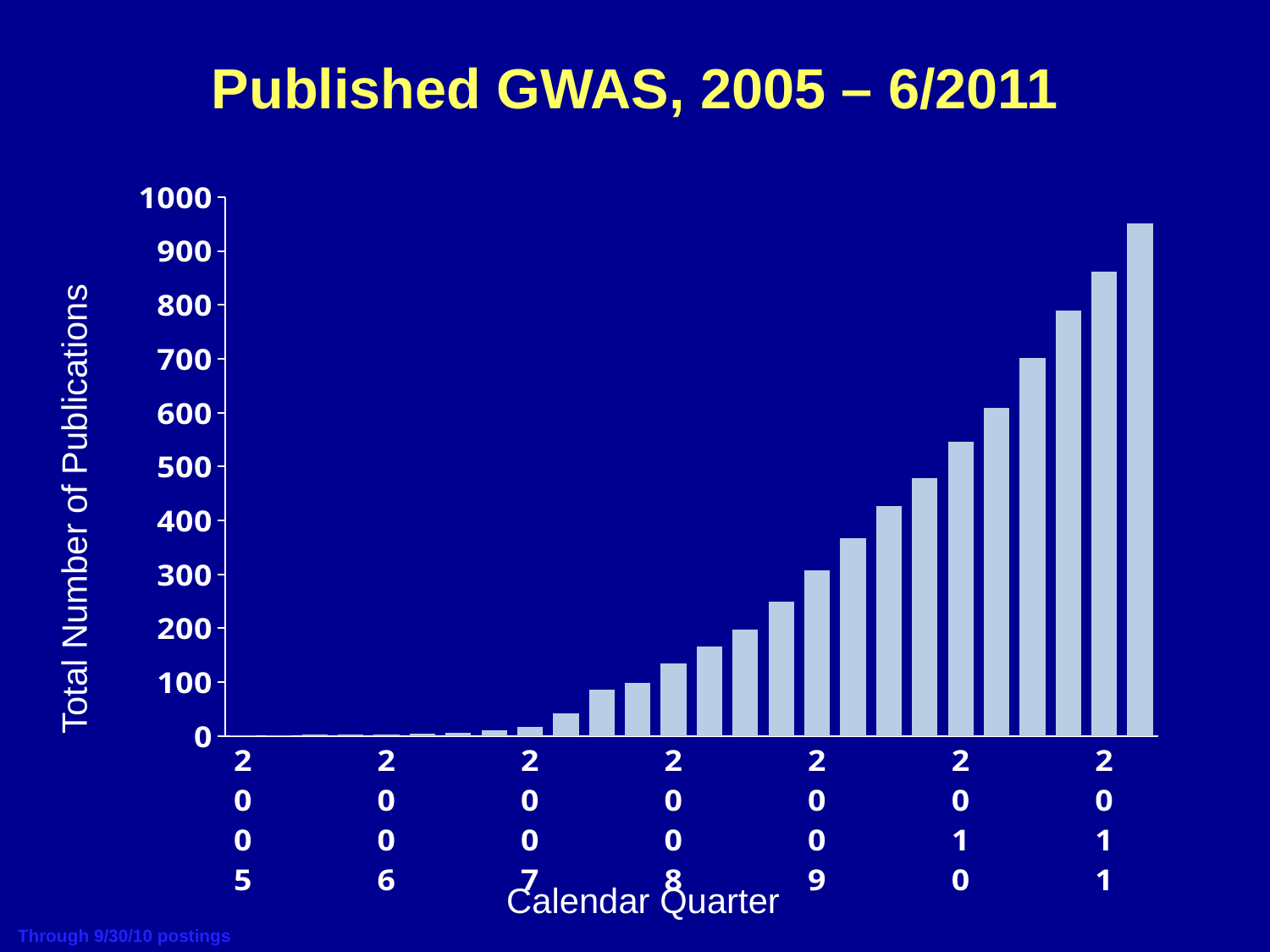
Do the bar values rise or fall from left to right along the x axis? rise Is the value of the rightmost bar greater or less than 1000? less Which year on the x axis contains the shortest bars? 2005 Is the value of the tallest (rightmost) bar greater or less than 900? greater How many year labels are shown along the x axis? 7 Which year on the x axis contains the tallest bar? 2011 What is the highest tick value shown on the vertical axis? 1000 Which is larger: the rightmost bar or the bar immediately to its left? the rightmost bar What is the label of the vertical axis? Total Number of Publications What is the title of the chart? Published GWAS, 2005 – 6/2011 Is the value of the leftmost bar (2005) greater or less than 100? less What kind of chart is shown on the slide? bar chart